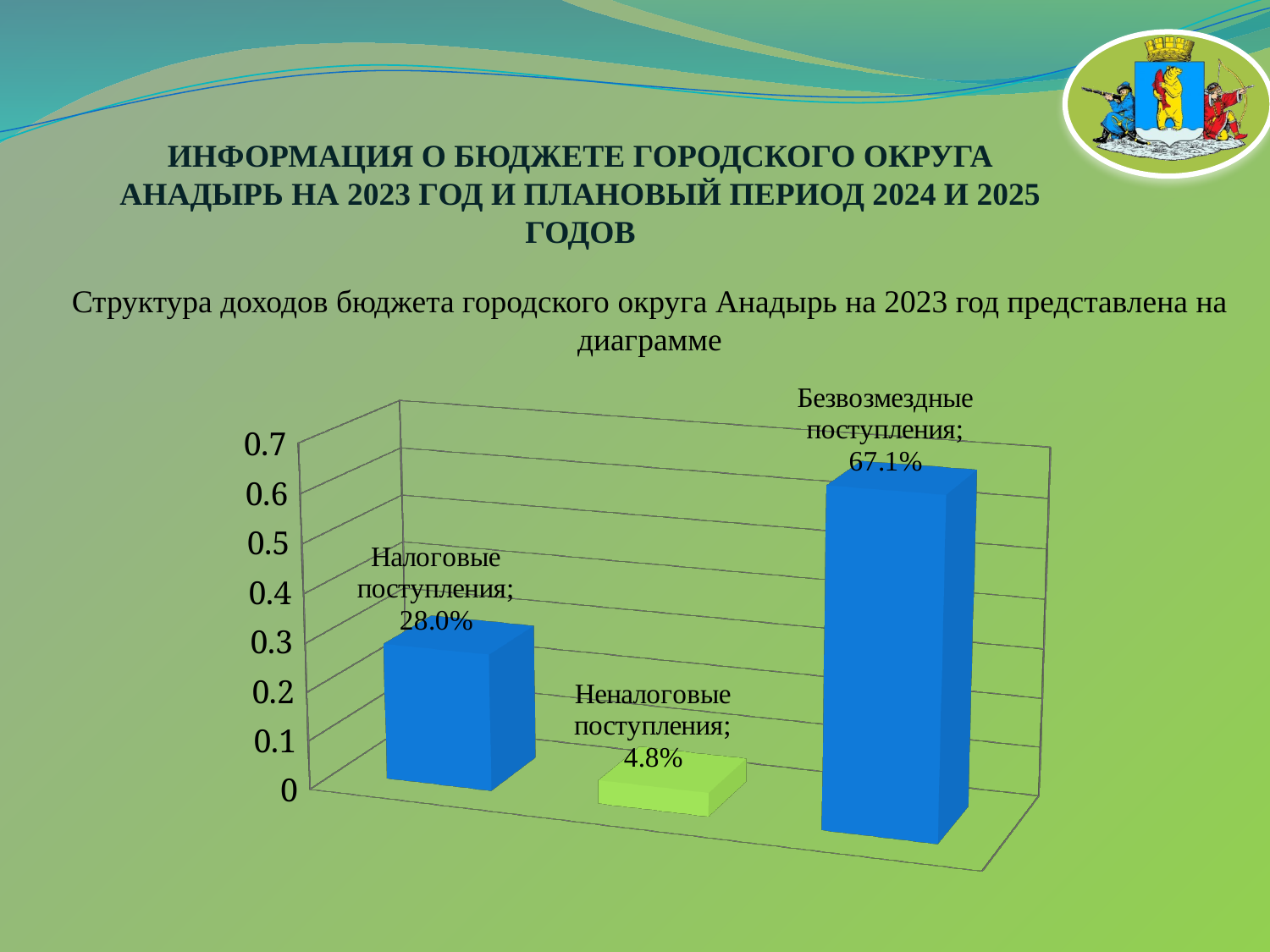
What is the value for Налоговые поступления? 28.0% What is the difference between Налоговые поступления and Неналоговые поступления? 23.2% Which category has the lowest value? Неналоговые поступления What is the highest tick value shown on the vertical axis? 0.7 How many categories are shown in the chart? 3 What is the difference between Безвозмездные поступления and Налоговые поступления? 39.1% What is the value for Безвозмездные поступления? 67.1% Is the value for Безвозмездные поступления greater or less than 0.6 on the axis? greater Which is larger, Налоговые поступления or Неналоговые поступления? Налоговые поступления What is the value for Неналоговые поступления? 4.8% Which category has the highest value? Безвозмездные поступления What kind of chart is shown on the slide? bar chart